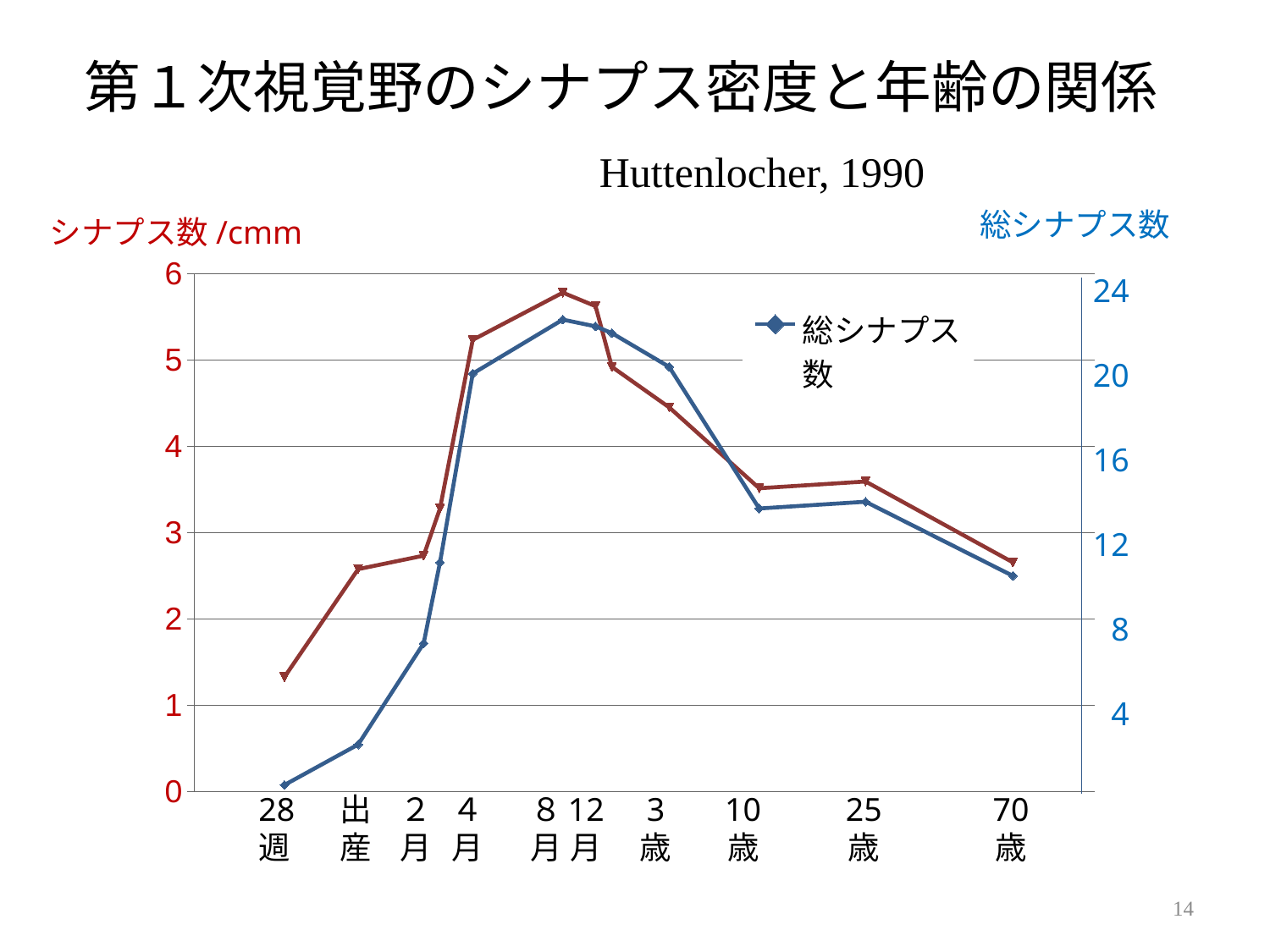
At which age label does the red シナプス数 /cmm line reach its highest value? 8月 What is the legend entry shown in the chart? 総シナプス数 Is the value of the blue 総シナプス数 line at 70歳 (right axis) greater or less than 12? less What kind of chart is shown on the slide? line chart At which age label is the blue 総シナプス数 line at its lowest value? 28週 How many age labels are shown along the x axis? 10 Is the value of the blue 総シナプス数 line at 出産 (right axis) greater or less than 4? less Is the value of the red シナプス数 /cmm line at 4月 greater or less than 5? greater From 8月 to 70歳, do the values of the red シナプス数 /cmm line rise or fall overall? fall What is the label of the left vertical axis? シナプス数 /cmm How many series does the legend list? 1